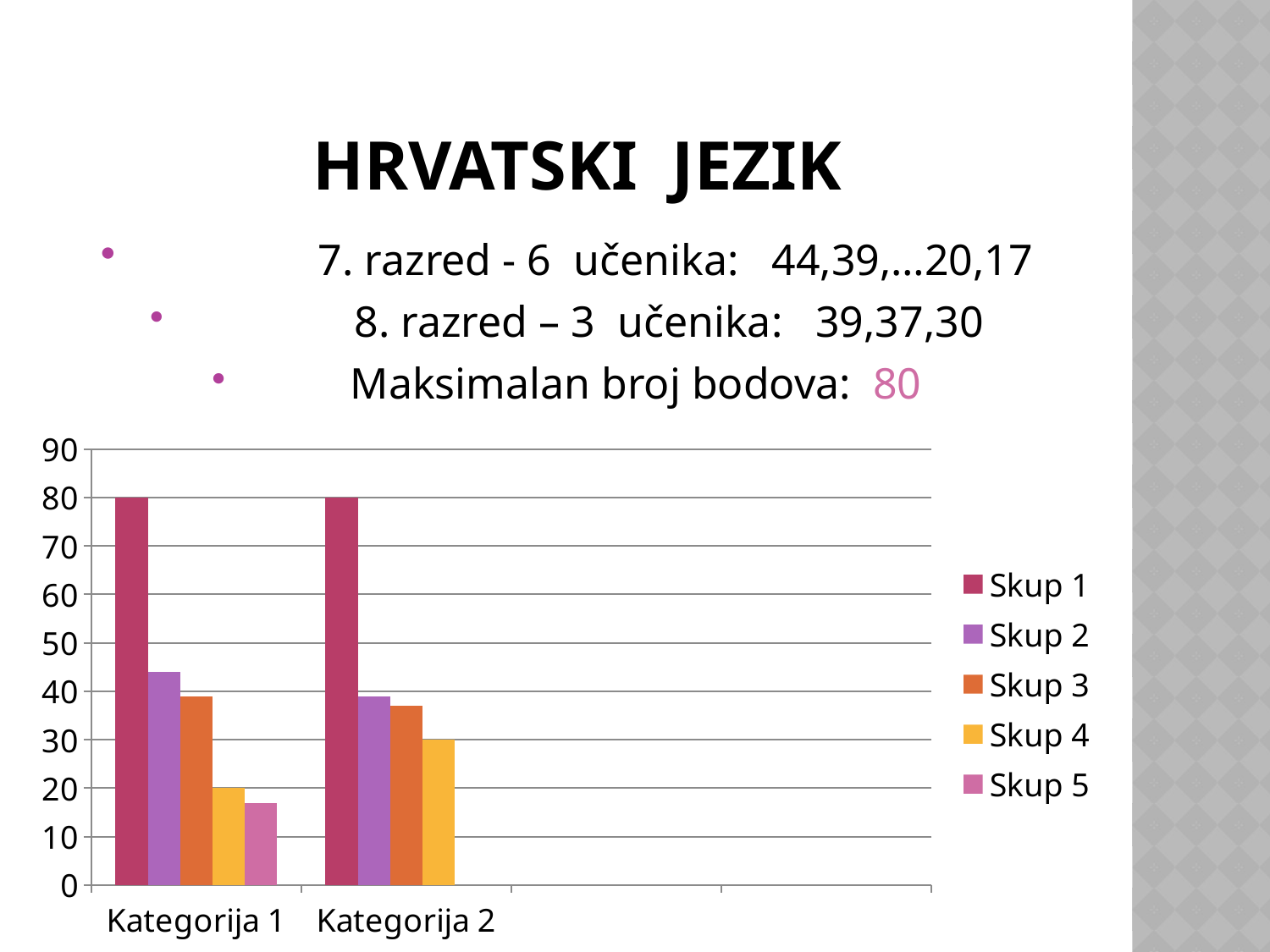
Is the value of Skup 2 for Kategorija 1 greater or less than 40? greater What kind of chart is shown on the slide? bar chart Is the value of Skup 5 for Kategorija 1 greater or less than 20? less How many series does the chart legend list? 5 Which series has the highest value in Kategorija 1? Skup 1 What is the value of Skup 1 for Kategorija 1? 80 Which series has the lowest value in Kategorija 1? Skup 5 What is the value of Skup 4 for Kategorija 1? 20 What is the value of Skup 4 for Kategorija 2? 30 For Skup 4, which category has the larger value, Kategorija 1 or Kategorija 2? Kategorija 2 What is the difference between Skup 1 and Skup 4 in Kategorija 1? 60 How many categories are shown on the x axis of the chart? 2